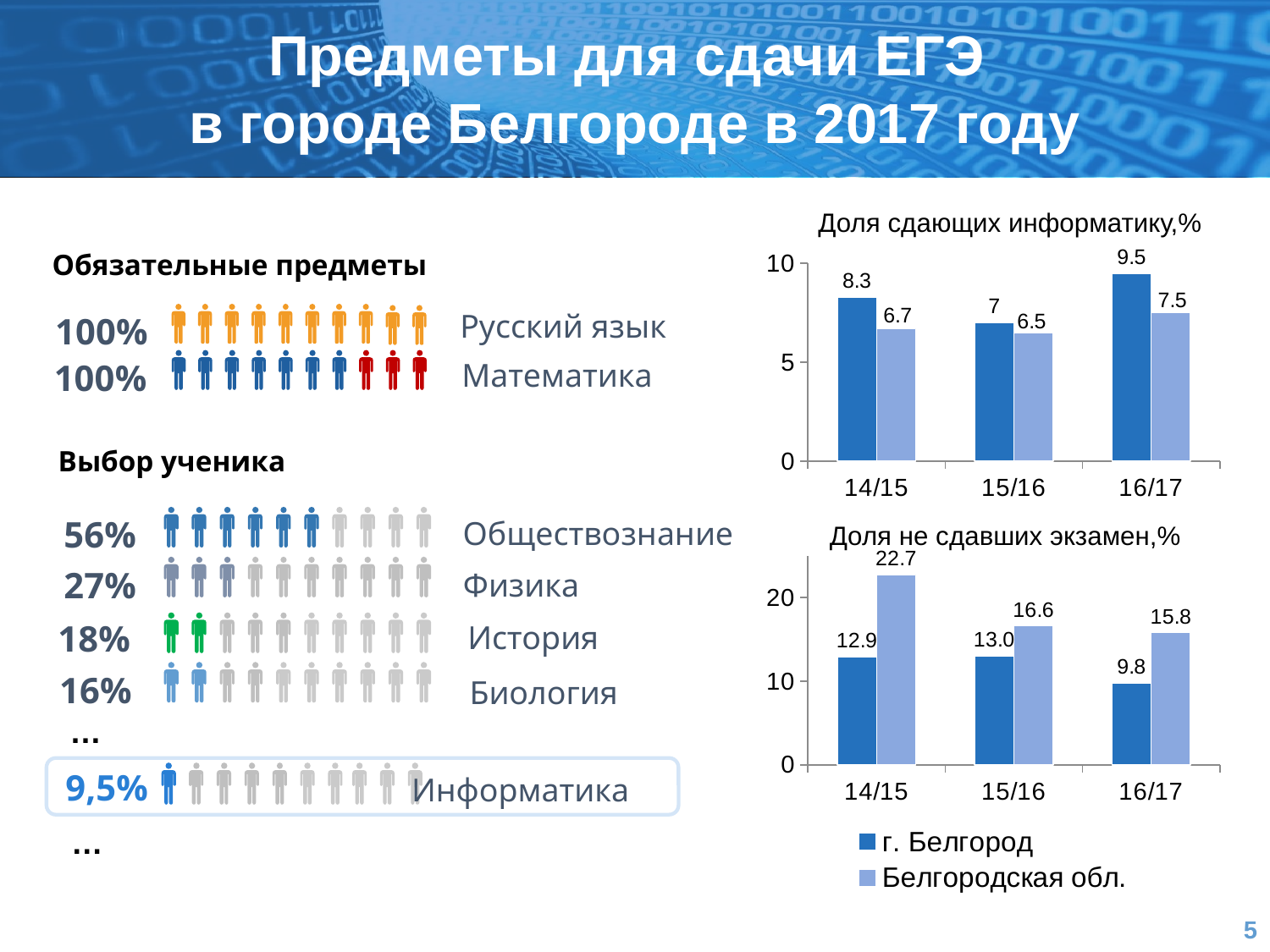
In the chart titled "Доля сдающих информатику,%", what is the value for г. Белгород in 14/15? 8.3 In the chart titled "Доля не сдавших экзамен,%", what is the value for г. Белгород in 16/17? 9.8 What kind of chart is the chart titled "Доля сдающих информатику,%"? bar chart In the chart titled "Доля не сдавших экзамен,%", does the value for Белгородская обл. rise or fall from 14/15 to 16/17? fall How many series does the legend list for the bar charts on the slide? 2 In the chart titled "Доля не сдавших экзамен,%", which is larger in 15/16: г. Белгород or Белгородская обл.? Белгородская обл. In the chart titled "Доля сдающих информатику,%", which year has the highest value for г. Белгород? 16/17 In the chart titled "Доля не сдавших экзамен,%", what is the value for Белгородская обл. in 14/15? 22.7 In the chart titled "Доля не сдавших экзамен,%", which year has the lowest value for г. Белгород? 16/17 In the chart titled "Доля сдающих информатику,%", what is the difference between г. Белгород and Белгородская обл. in 16/17? 2 In the chart titled "Доля не сдавших экзамен,%", what is the difference between Белгородская обл. and г. Белгород in 14/15? 9.8 In the chart titled "Доля сдающих информатику,%", what is the value for Белгородская обл. in 16/17? 7.5